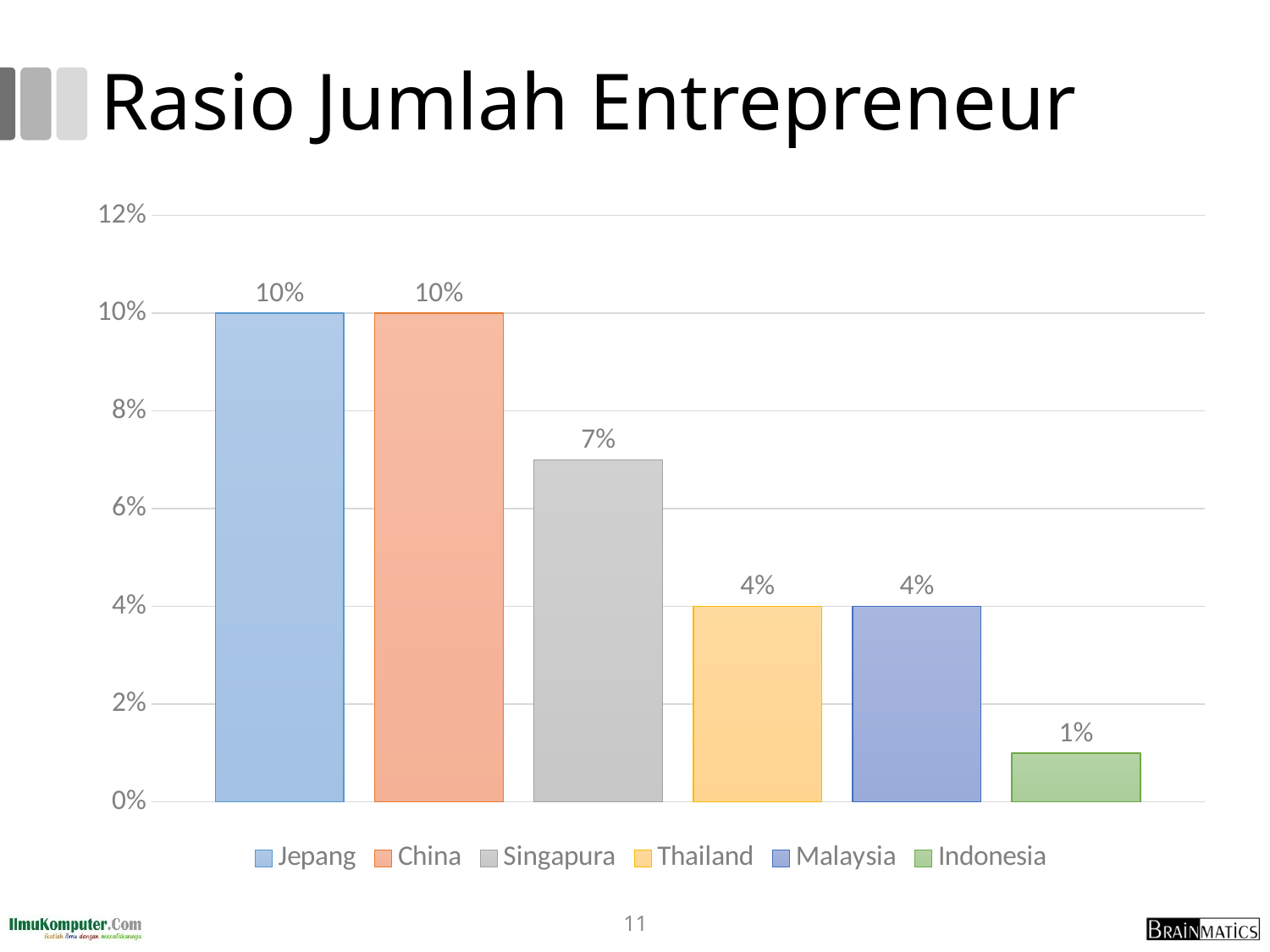
Do the values rise or fall from left to right across the chart? fall What is the value for Indonesia? 1% Is the value for Singapura greater or less than 6%? greater What kind of chart is shown on the slide? bar chart Which country has the lowest value? Indonesia What is the difference between the values for Jepang and Singapura? 3% What is the value for Malaysia? 4% How many bars are shown in the chart? 6 What is the value for Singapura? 7% What is the difference between the values for Singapura and Indonesia? 6% How many entries does the legend list? 6 Which is larger, the value for Singapura or the value for Thailand? Singapura